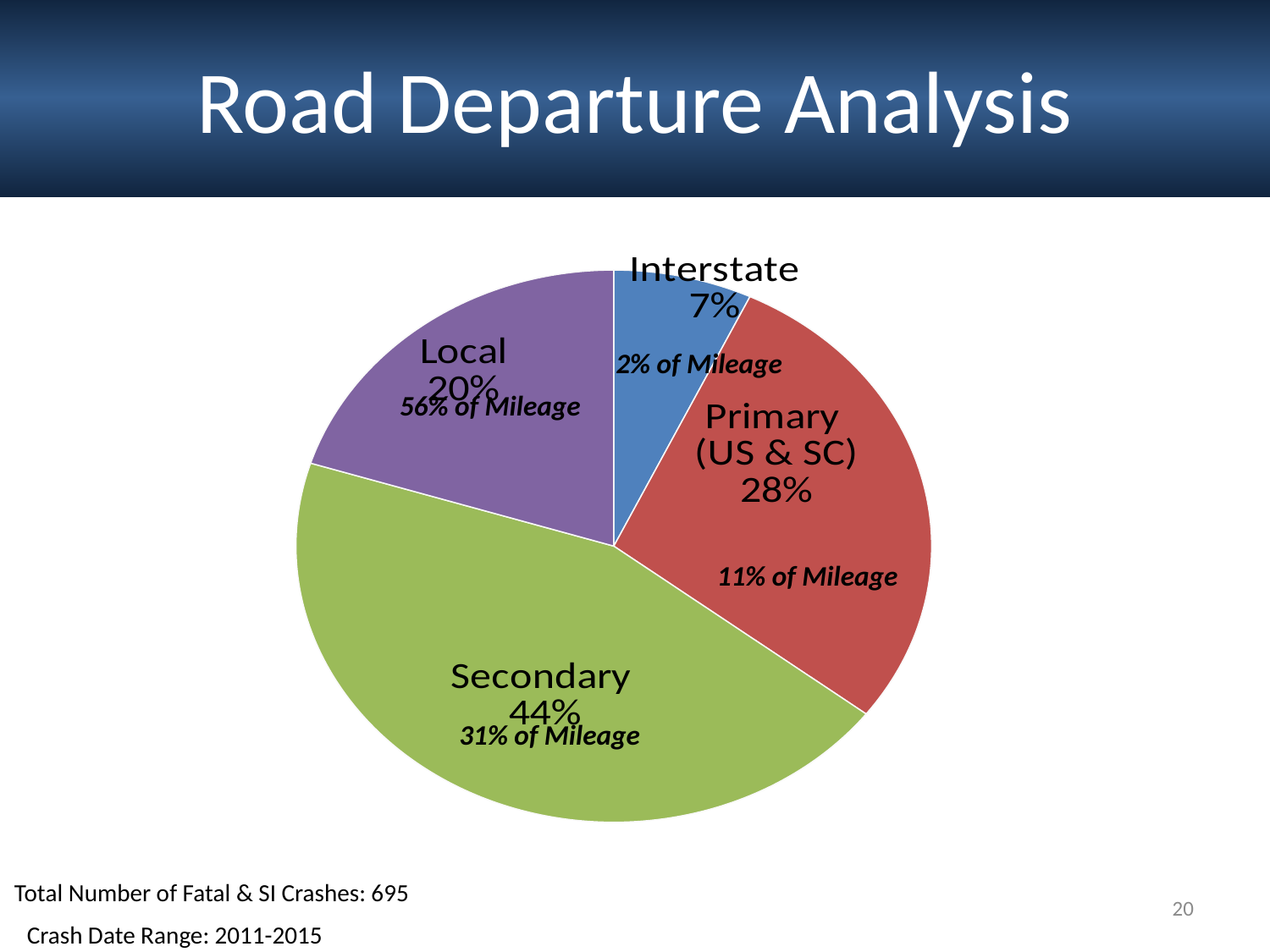
What share of the pie does the Local slice represent? 20% What kind of chart is shown on the slide? pie chart What share of the pie does the Secondary slice represent? 44% Which slice is larger, Local or Primary (US & SC)? Primary (US & SC) What share of the pie does the Interstate slice represent? 7% What is the difference in percentage points between the Secondary and Primary (US & SC) slices? 16 Which road type has the largest slice of the pie? Secondary What is the total number of Fatal & SI crashes stated below the chart? 695 How many slices does the pie chart have? 4 Which road type has the smallest slice of the pie? Interstate What percentage of mileage is annotated for the Local slice? 56% of Mileage